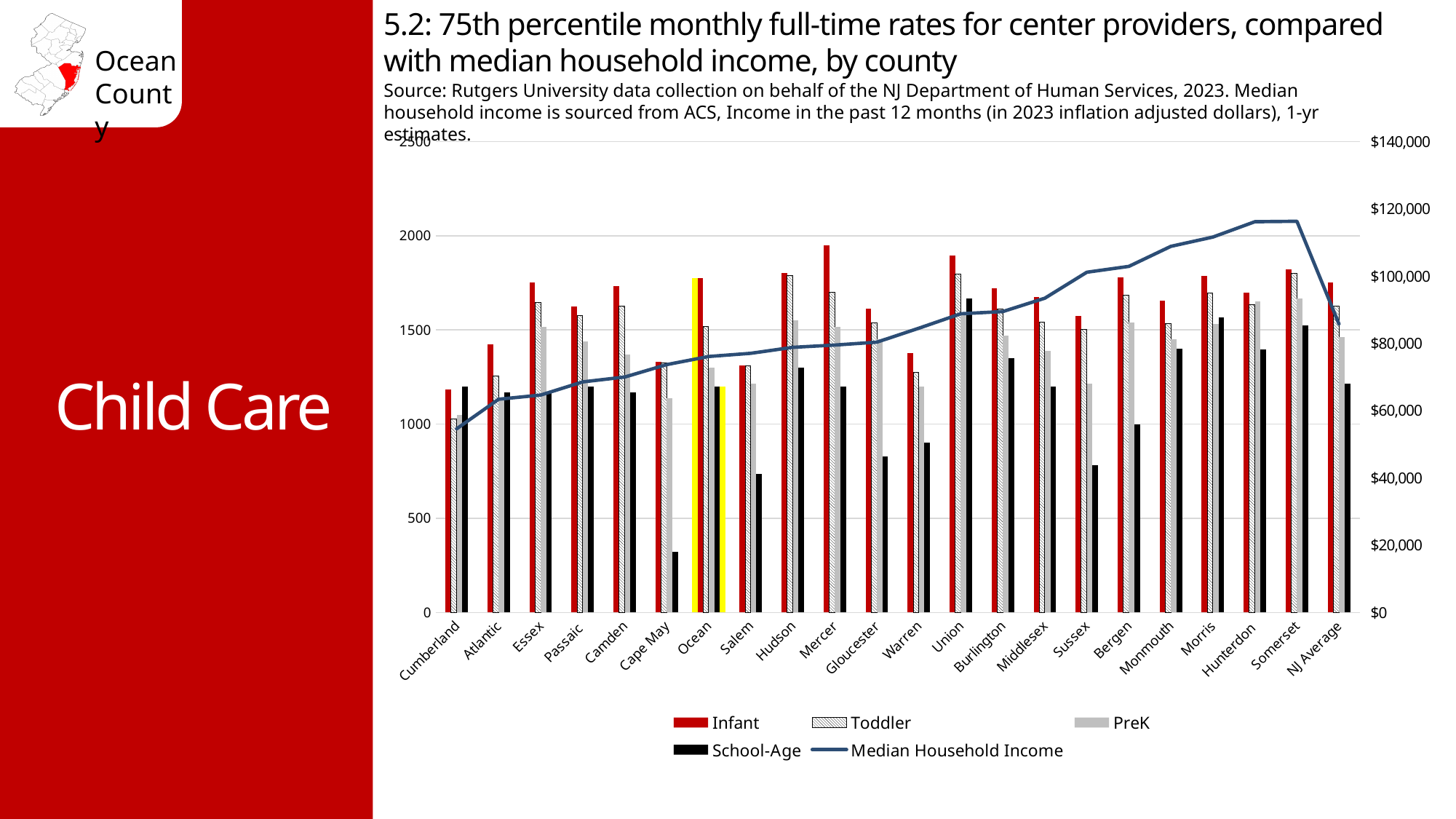
How many categories are shown along the x axis? 22 Is the School-Age rate for Cape May greater or less than 500? less Which is larger, the Infant rate for Ocean or the Infant rate for Salem? Ocean Is the Infant rate for Cumberland greater or less than 1000? greater Which county's bars are highlighted in yellow? Ocean Is the Median Household Income for Somerset greater or less than $100,000? greater Which county has the highest Infant rate? Mercer Which county has the lowest School-Age rate? Cape May Which county has the lowest Infant rate? Cumberland What kind of chart is shown on the slide? Bar chart with a line How many series does the legend list? 5 Does the Median Household Income line generally rise or fall from Cumberland to Somerset? rise